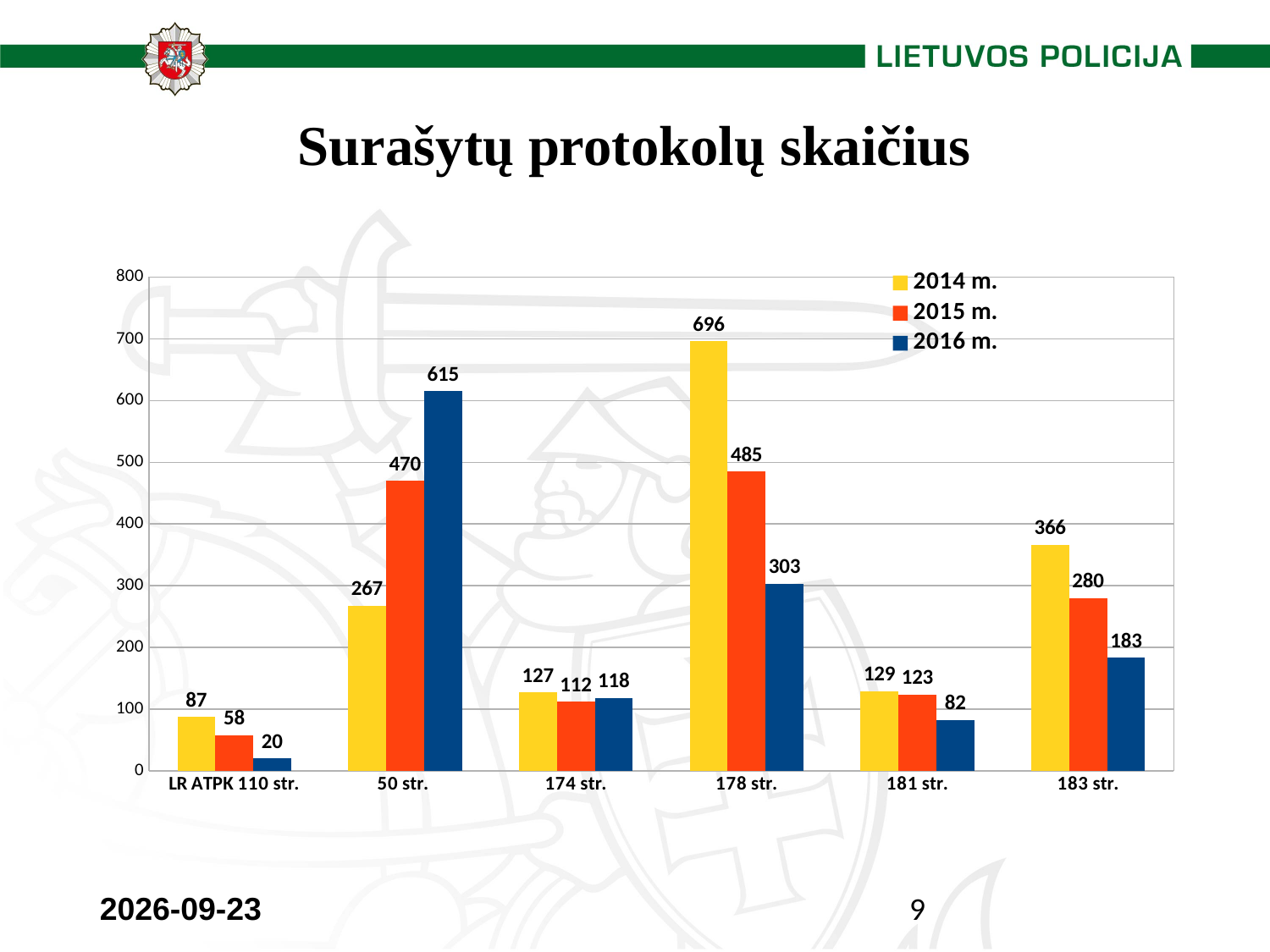
Which is larger in the 50 str. category: the 2015 m. value or the 2016 m. value? 2016 m. What kind of chart is shown on the slide? Bar chart Which category has the lowest value for 2016 m.? LR ATPK 110 str. What is the difference between the 2014 m. and 2016 m. values in the 178 str. category? 393 Do the values for 2016 m. rise or fall from 178 str. to 183 str.? Fall How many categories are shown on the x axis? 6 What is the value for 2014 m. in the 178 str. category? 696 What is the value for 2015 m. in the 183 str. category? 280 How many series does the legend list? 3 What is the title of the chart? Surašytų protokolų skaičius What is the value for 2016 m. in the 50 str. category? 615 Which category has the highest value for 2014 m.? 178 str.